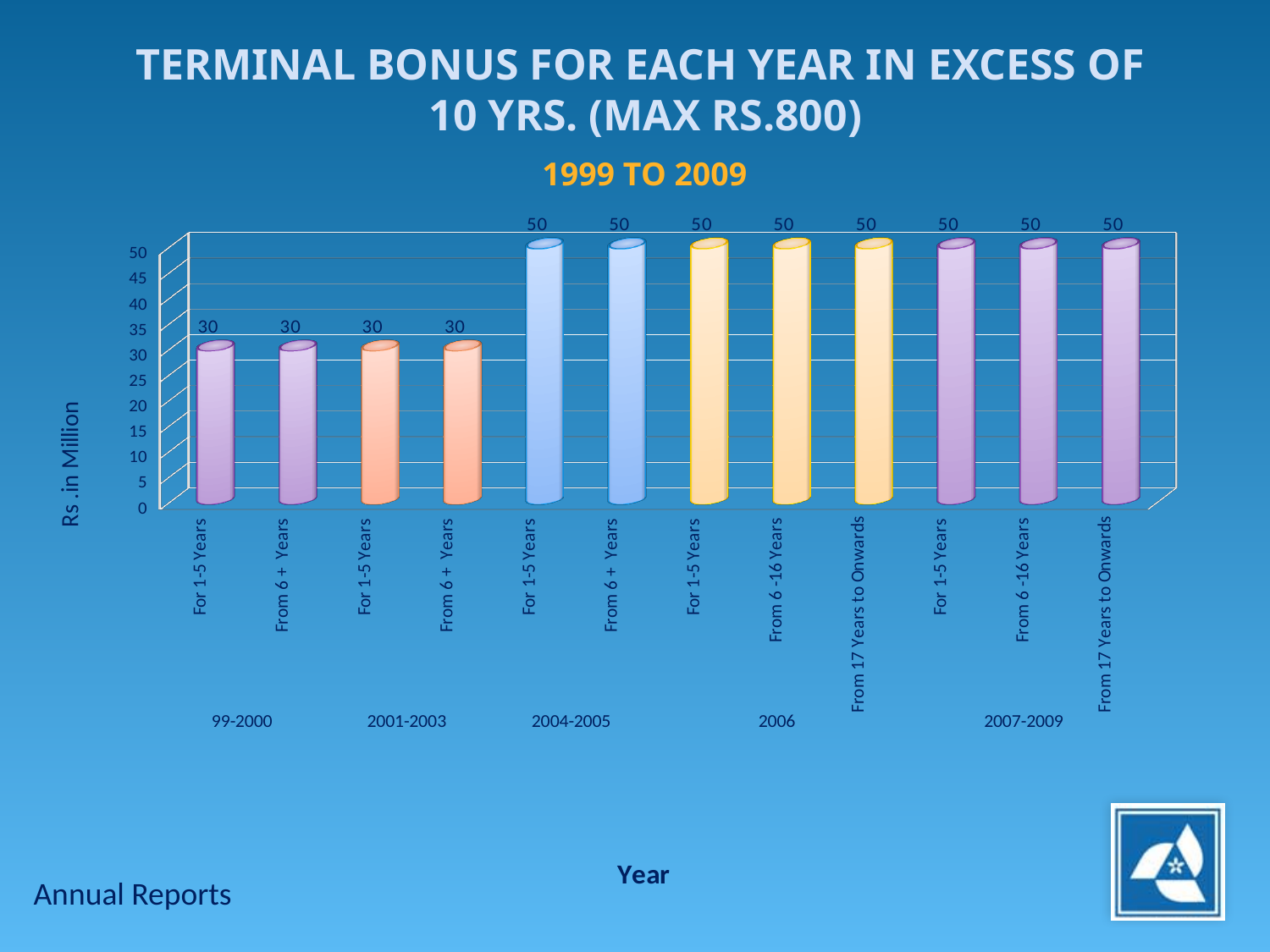
What is the value for 'From 6 -16 Years' in the 2007-2009 group? 50 What is the value for 'From 17 Years to Onwards' in the 2006 group? 50 Which is larger: the value for 'From 6 + Years' in 99-2000 or the value for 'From 6 + Years' in 2004-2005? From 6 + Years in 2004-2005 What is the value for 'From 6 + Years' in the 2004-2005 group? 50 What period is given in the subtitle below the chart title? 1999 TO 2009 How many bars are plotted on the chart? 12 What is the label of the vertical axis? Rs .in Million What is the difference between the value for 'For 1-5 Years' in 2004-2005 and the value for 'For 1-5 Years' in 2001-2003? 20 How many year groups are shown along the x axis? 5 What kind of chart is shown on the slide? Bar chart What is the value for 'For 1-5 Years' in the 99-2000 group? 30 Do the values rise or fall from the 99-2000 group to the 2007-2009 group? Rise